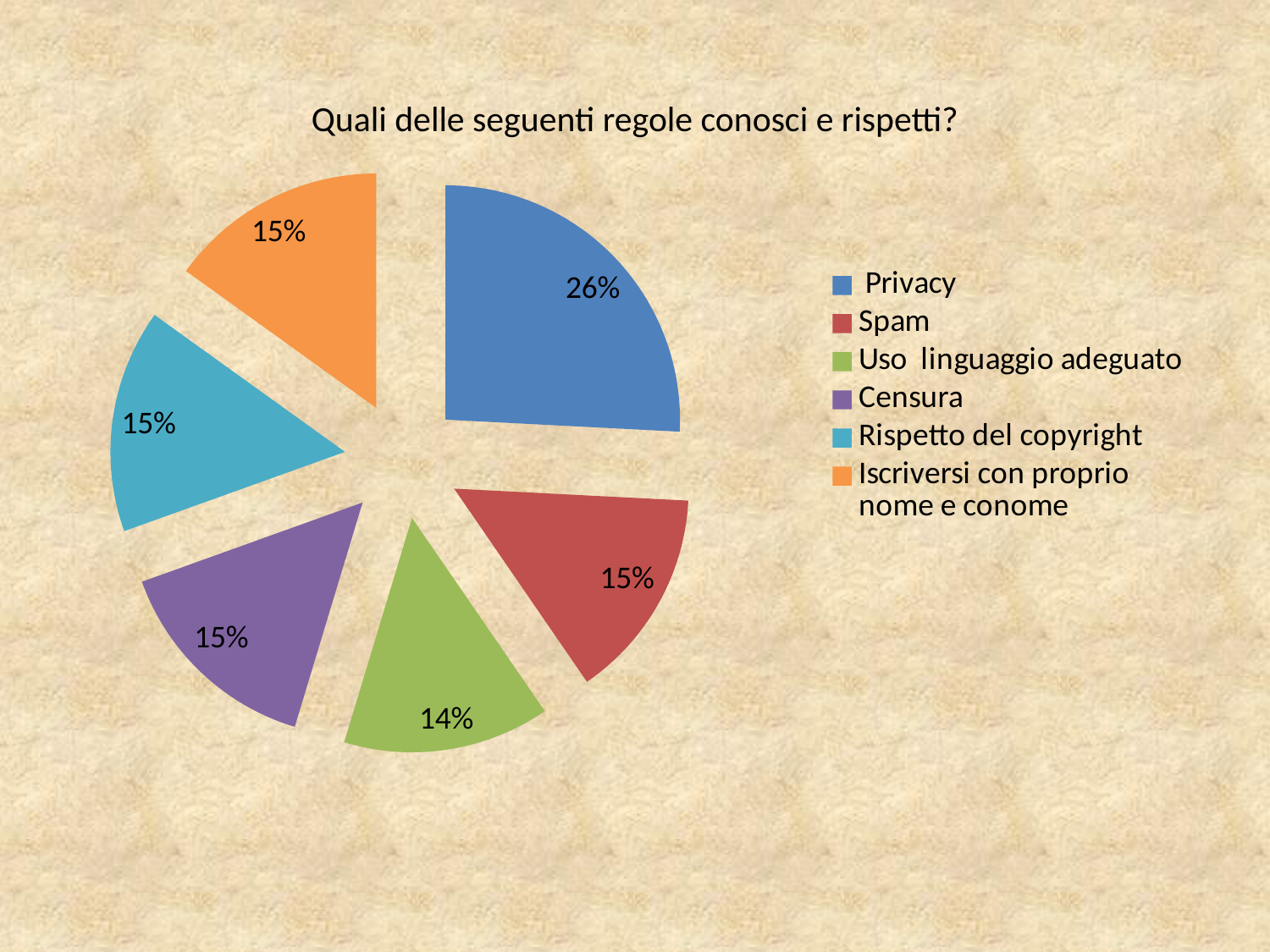
What share of the pie does Uso linguaggio adeguato represent? 14% What is the difference between the Privacy share and the Censura share? 11% What is the title of the chart? Quali delle seguenti regole conosci e rispetti? Which is larger, the share for Privacy or the share for Iscriversi con proprio nome e conome? Privacy What is the value shown for Spam? 15% Which category has the smallest slice of the pie? Uso linguaggio adeguato What share of the pie does Privacy represent? 26% Which category has the largest slice of the pie? Privacy What is the value shown for Rispetto del copyright? 15% What type of chart is shown on the slide? pie chart How many categories does the legend list? 6 What colour is the slice for Censura? purple